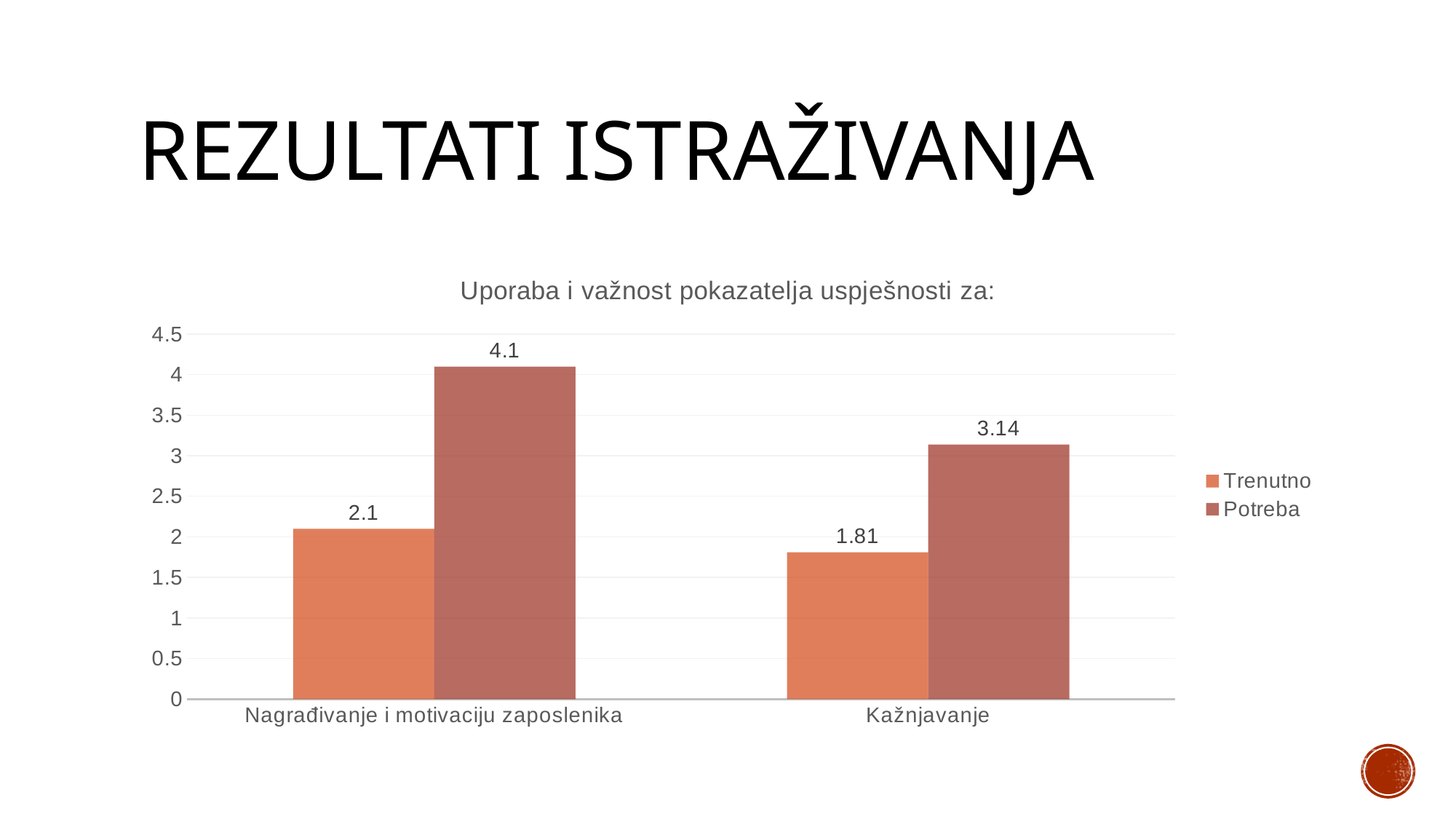
What is the Trenutno value for Kažnjavanje? 1.81 Which is larger for Kažnjavanje, the Trenutno value or the Potreba value? Potreba What is the Potreba value for Kažnjavanje? 3.14 What is the difference between the Potreba and Trenutno values for Nagrađivanje i motivaciju zaposlenika? 2 How many categories are shown on the x axis? 2 What is the Potreba value for Nagrađivanje i motivaciju zaposlenika? 4.1 What is the difference between the Potreba and Trenutno values for Kažnjavanje? 1.33 Which category has the highest Potreba value? Nagrađivanje i motivaciju zaposlenika Which category has the lowest Trenutno value? Kažnjavanje How many series does the legend list? 2 What is the Trenutno value for Nagrađivanje i motivaciju zaposlenika? 2.1 What is the title of the chart? Uporaba i važnost pokazatelja uspješnosti za: